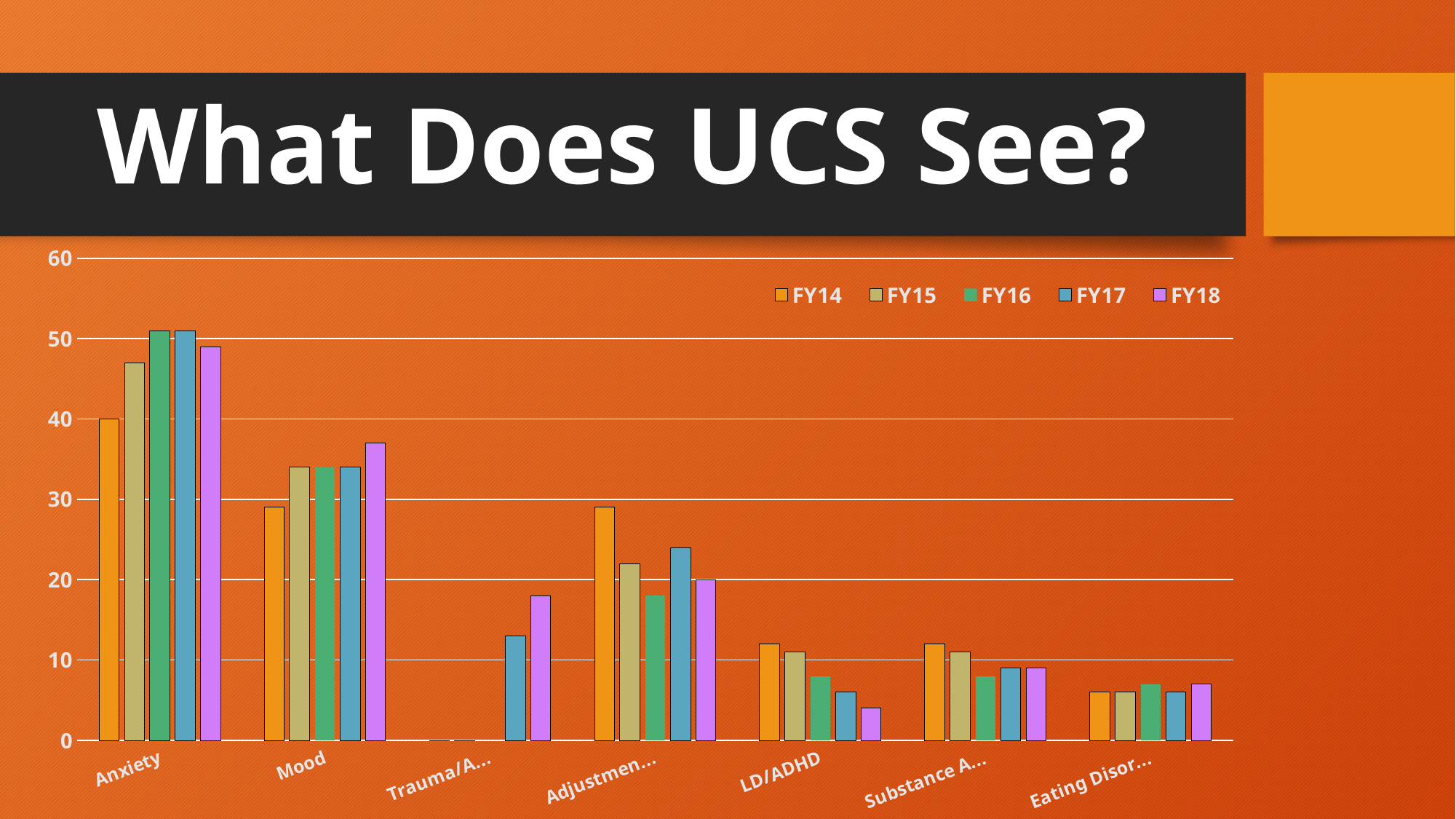
Is the FY18 value for LD/ADHD greater or less than 10? less For Mood, which is larger: the FY14 value or the FY18 value? FY18 How many categories are shown along the x axis? 7 Is the FY14 value for Mood greater or less than 30? less What kind of chart is shown on the slide? bar chart What is the title of the slide containing the chart? What Does UCS See? Is the FY18 value for Mood greater or less than 30? greater How many series does the legend list? 5 Which category has the highest bars overall? Anxiety Which is larger for FY14: the value for Anxiety or the value for Mood? Anxiety Which category has the lowest FY14 value? Trauma/A...